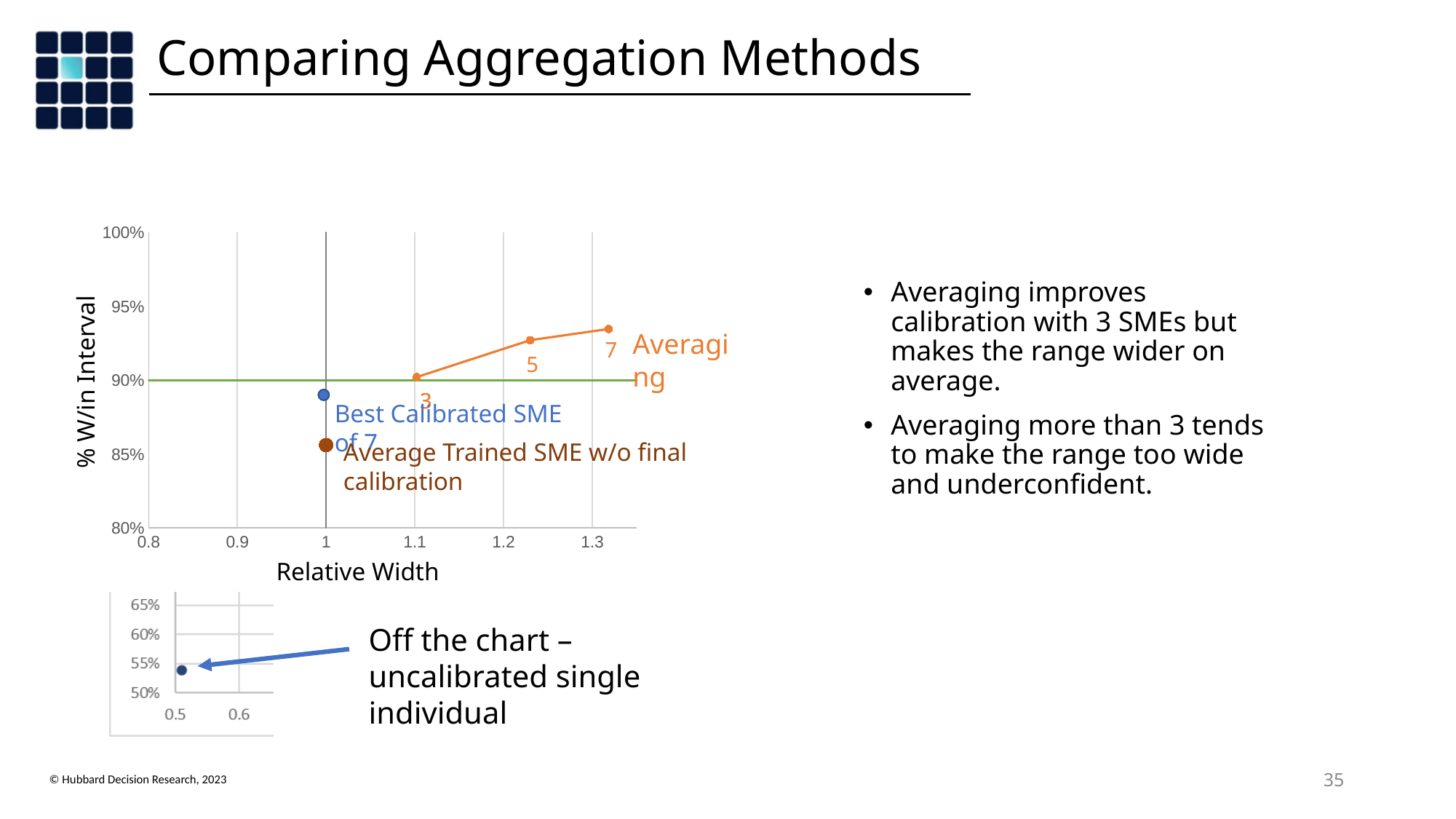
How many points are plotted on the Averaging line of the main chart? 3 On the small inset chart at the bottom left, is the % W/in Interval for the uncalibrated single individual greater or less than 60%? less What kind of chart is the main chart on the slide? scatter chart On the main chart, is the % W/in Interval for the Averaging point labelled 7 greater or less than 90%? greater On the main chart, which Averaging point has the larger Relative Width: the one labelled 3 or the one labelled 7? 7 On the main chart, which has the higher % W/in Interval: Best Calibrated SME of 7 or Average Trained SME w/o final calibration? Best Calibrated SME of 7 On the main chart, as Relative Width increases along the Averaging line, does % W/in Interval rise or fall? rise What is the title of the y axis of the main chart? % W/in Interval On the main chart, is the % W/in Interval for Best Calibrated SME of 7 greater or less than 90%? less What is the title of the x axis of the main chart? Relative Width On the main chart, which plotted point has the highest % W/in Interval? Averaging 7